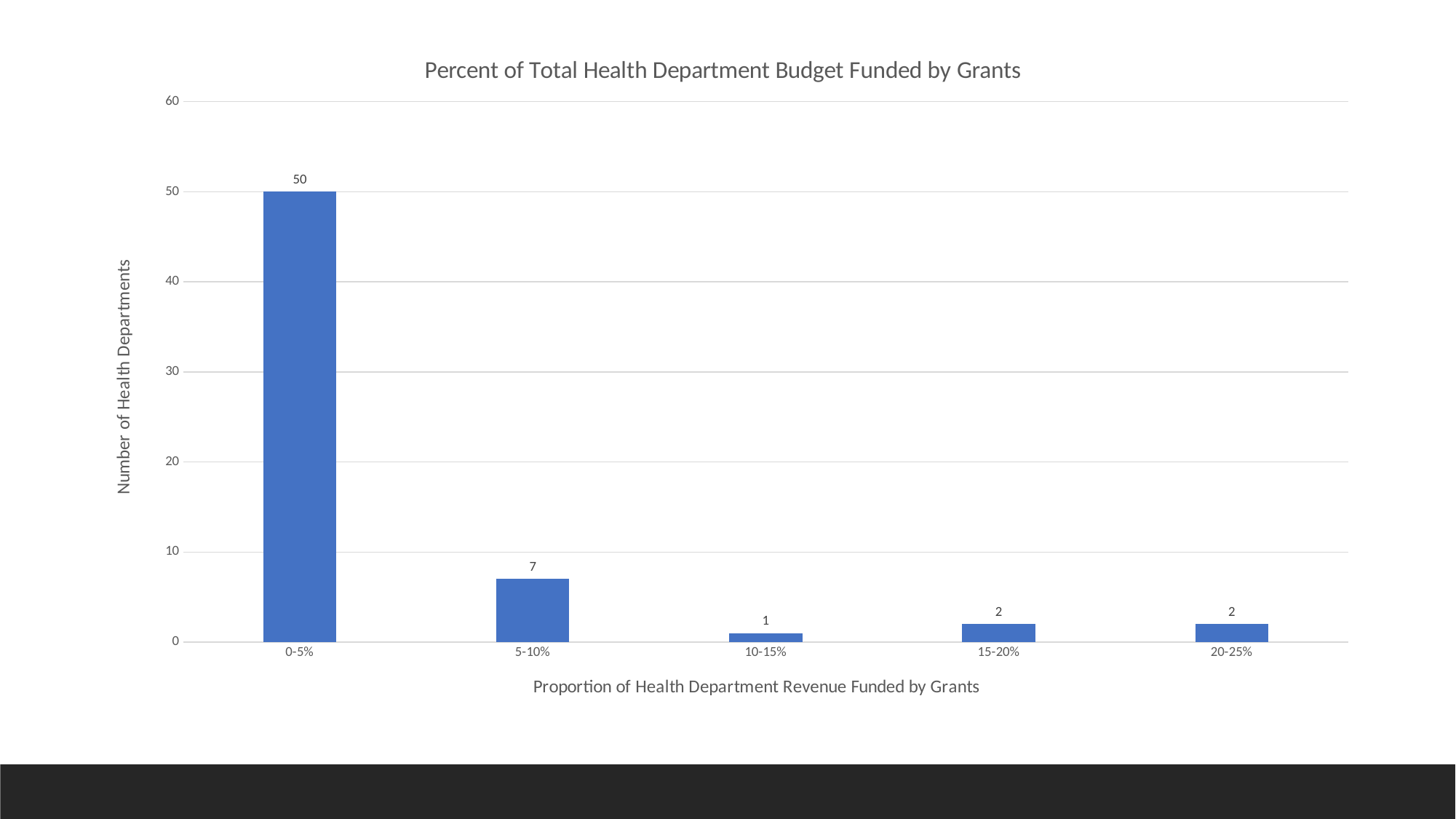
Which category has the highest number of health departments? 0-5% What is the number of health departments in the 0-5% category? 50 What is the label of the y axis? Number of Health Departments What is the number of health departments in the 20-25% category? 2 Which has more health departments, the 5-10% category or the 15-20% category? 5-10% What is the title of the chart? Percent of Total Health Department Budget Funded by Grants What is the difference between the number of health departments in the 0-5% category and the 5-10% category? 43 How many categories are shown on the x axis? 5 What is the number of health departments in the 5-10% category? 7 Which category has the lowest number of health departments? 10-15% What kind of chart is shown on the slide? Bar chart What is the number of health departments in the 10-15% category? 1